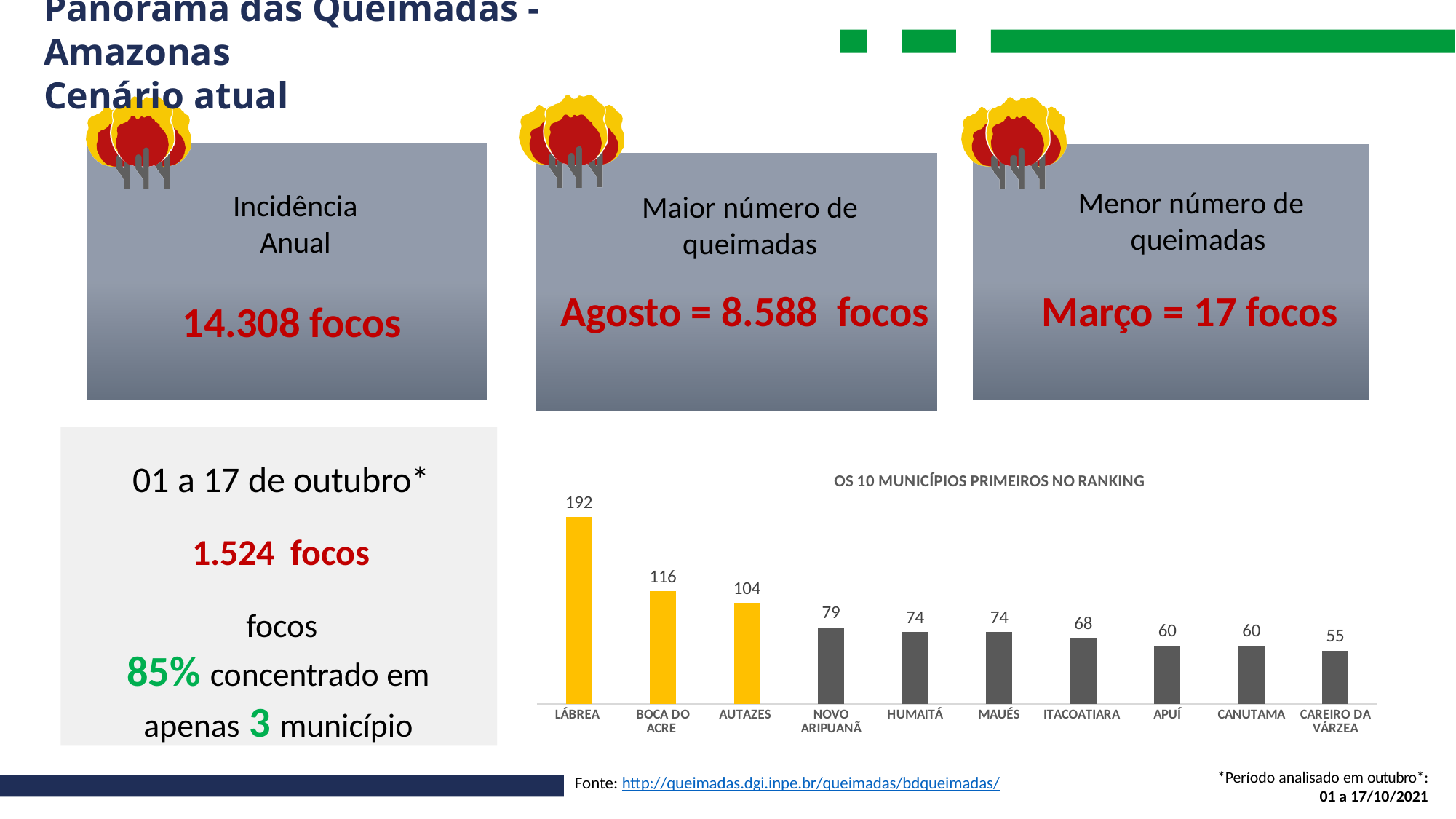
Which is larger, the value for BOCA DO ACRE or the value for AUTAZES? BOCA DO ACRE Which municipality has the lowest value in the chart? CAREIRO DA VÁRZEA What is the value for LÁBREA in the chart 'OS 10 MUNICÍPIOS PRIMEIROS NO RANKING'? 192 Which municipality has the highest value in the chart? LÁBREA What is the value for NOVO ARIPUANÃ in the chart? 79 What is the value for CAREIRO DA VÁRZEA in the chart? 55 How many municipalities are shown in the chart? 10 What is the difference between the values for AUTAZES and ITACOATIARA? 36 What kind of chart is 'OS 10 MUNICÍPIOS PRIMEIROS NO RANKING'? bar chart How many bars in the chart are coloured yellow? 3 What is the difference between the values for LÁBREA and BOCA DO ACRE? 76 Do the values in the chart rise or fall from left to right? fall